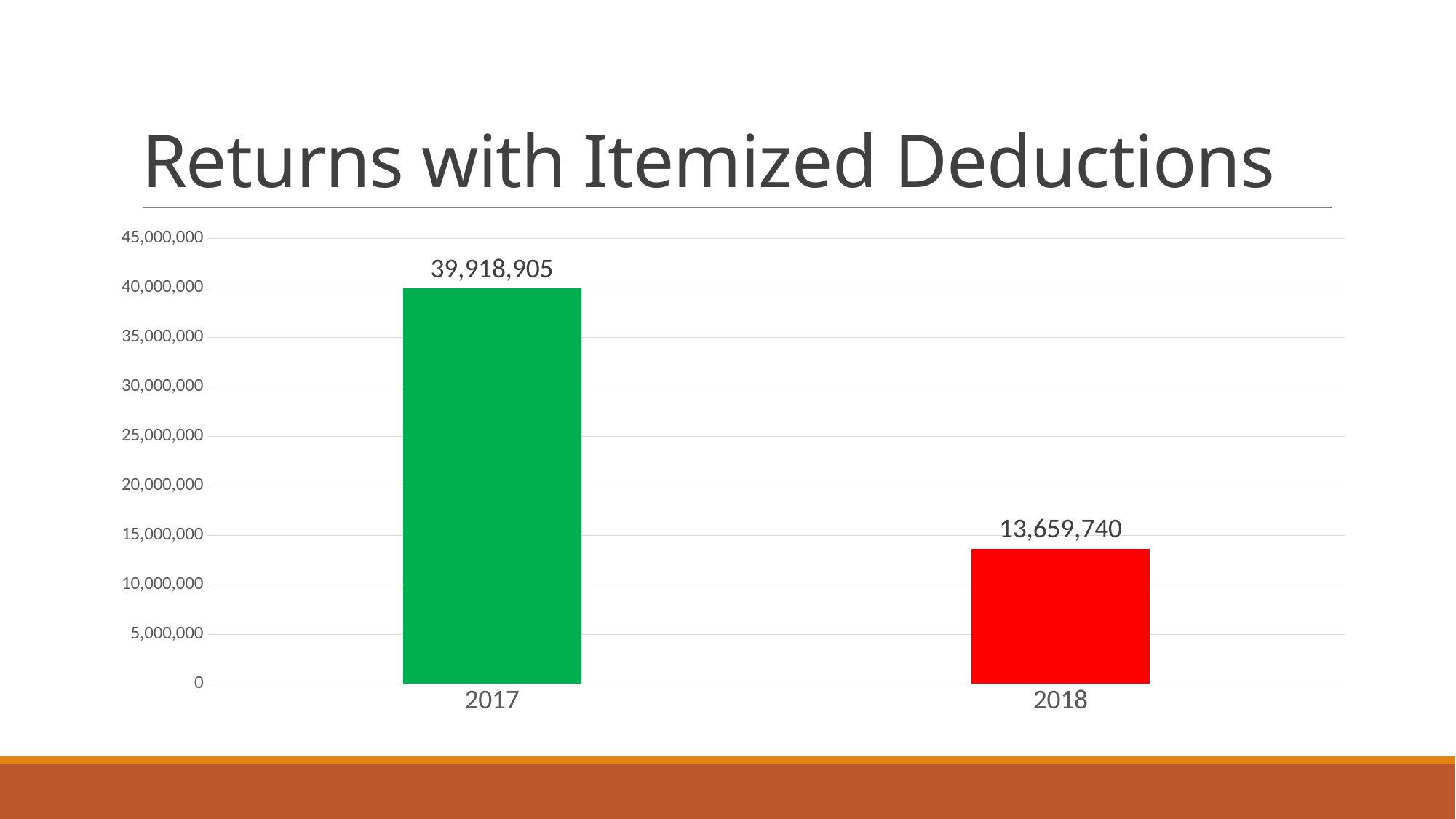
Do the values rise or fall from 2017 to 2018? fall Which year has the highest value? 2017 What is the difference between the 2017 and 2018 values? 26,259,165 How many categories are shown on the x axis? 2 What is the value for 2018? 13,659,740 Which is larger, the value for 2017 or the value for 2018? 2017 What is the title of the slide? Returns with Itemized Deductions What is the value for 2017? 39,918,905 What kind of chart is shown on the slide? bar chart Which year has the lowest value? 2018 Is the value for 2017 greater or less than 35,000,000? greater Is the value for 2018 greater or less than 15,000,000? less